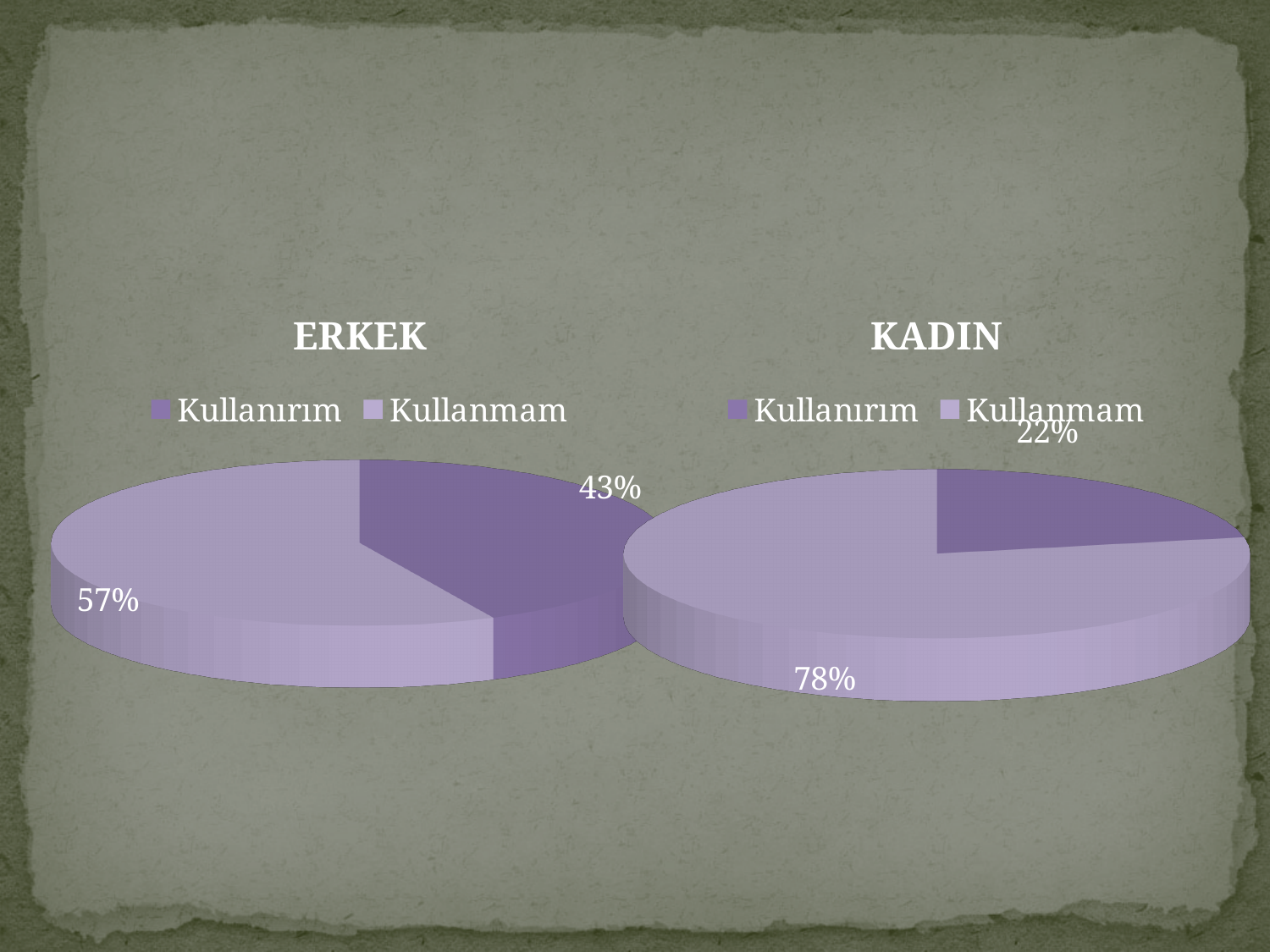
What type of chart is the ERKEK chart? Pie chart In the ERKEK chart, what percentage is shown for Kullanırım? 43% In the ERKEK chart, what percentage is shown for Kullanmam? 57% In the KADIN chart, what percentage is shown for Kullanmam? 78% In the ERKEK chart, which slice is the largest? Kullanmam In the KADIN chart, what is the difference between the Kullanmam and Kullanırım shares? 56% How many slices does the ERKEK pie chart have? 2 Which chart has the larger Kullanırım share, ERKEK or KADIN? ERKEK How many entries does the legend of the KADIN chart list? 2 In the KADIN chart, what percentage is shown for Kullanırım? 22% In the ERKEK chart, what is the difference between the Kullanmam and Kullanırım shares? 14% In the KADIN chart, which slice is the smallest? Kullanırım